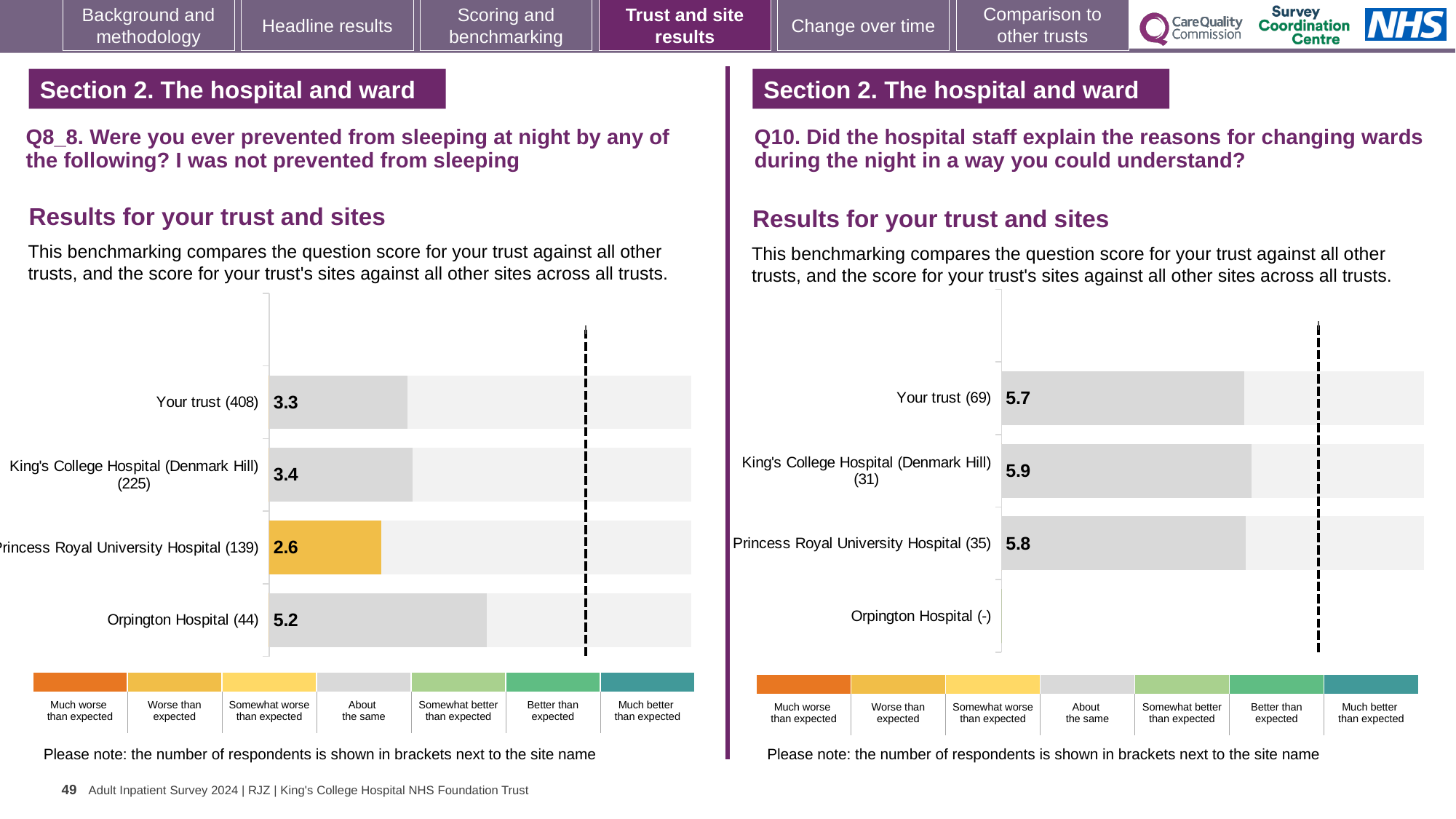
In the Q8_8 chart on the left, what is the difference between the scores for Orpington Hospital and Princess Royal University Hospital? 2.6 In the Q10 chart on the right, what is the score for Your trust? 5.7 In the Q8_8 chart on the left, what is the score for Princess Royal University Hospital? 2.6 In the Q8_8 chart on the left, what is the score for Orpington Hospital? 5.2 In the Q8_8 chart on the left, which bar is coloured differently from the others, indicating a 'Worse than expected' result? Princess Royal University Hospital In the Q10 chart on the right, which site has the higher score: King's College Hospital (Denmark Hill) or Princess Royal University Hospital? King's College Hospital (Denmark Hill) What type of chart is used on the left for Q8_8? Bar chart In the Q8_8 chart on the left, which site or trust row has the highest score? Orpington Hospital In the Q10 chart on the right, how many rows have a score bar plotted? 3 In the Q10 chart on the right, what is the score for King's College Hospital (Denmark Hill)? 5.9 In the Q8_8 chart on the left, which site or trust row has the lowest score? Princess Royal University Hospital In the Q10 chart on the right, how many respondents are shown in brackets for Princess Royal University Hospital? 35